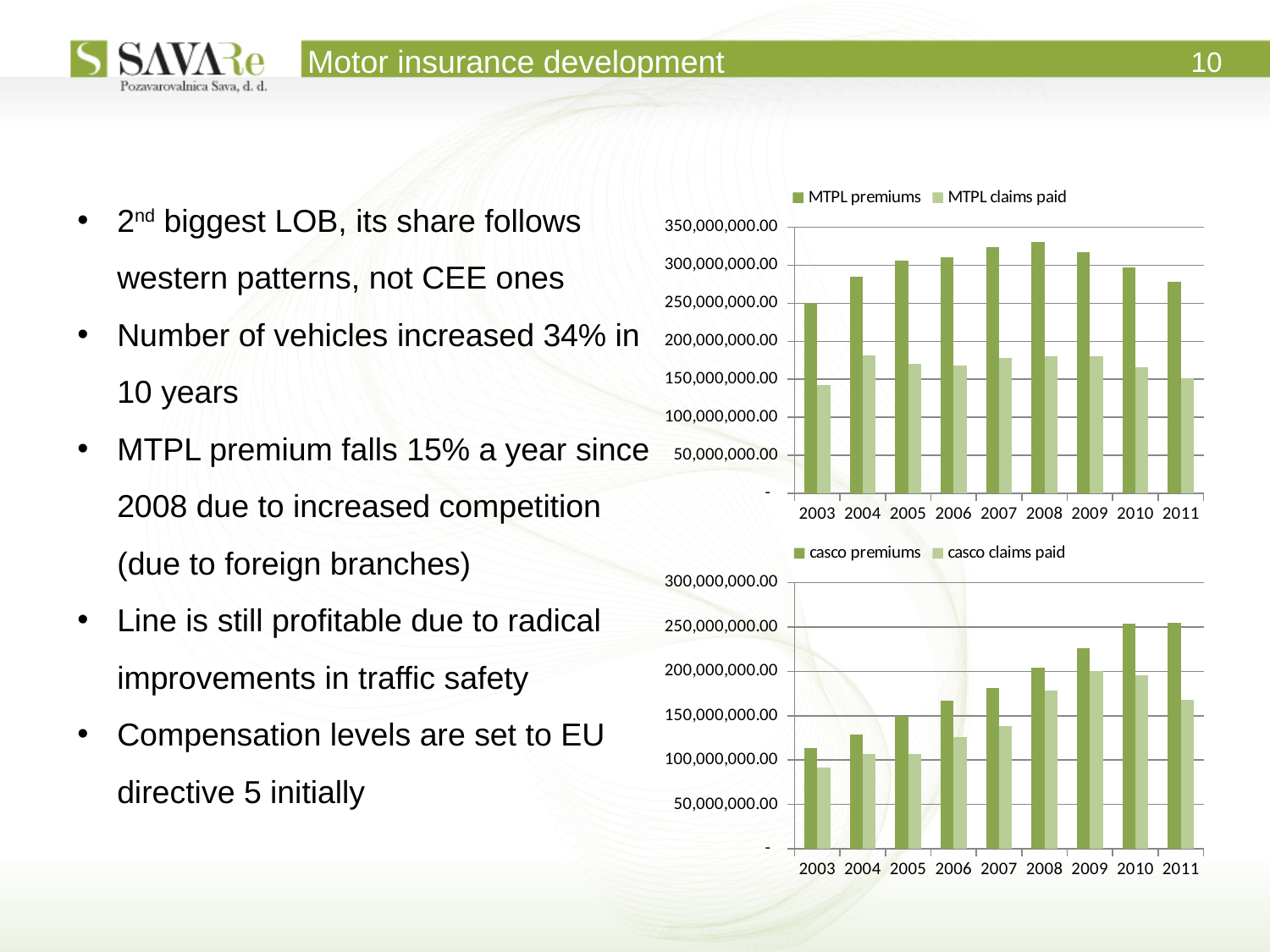
In the top chart (MTPL), which year has the lowest MTPL premiums? 2003 What are the two legend entries of the bottom chart? casco premiums, casco claims paid In the top chart (MTPL), is the value for MTPL claims paid in 2003 greater or less than 150,000,000.00? less How many series does the legend of the bottom chart (casco) list? 2 How many years are shown on the x axis of the top chart (MTPL)? 9 In the top chart (MTPL), which year has the highest MTPL premiums? 2008 In the top chart (MTPL), which is larger in 2011: MTPL premiums or MTPL claims paid? MTPL premiums In the top chart (MTPL), is the value for MTPL premiums in 2003 greater or less than 300,000,000.00? less In the bottom chart (casco), which year has the lowest casco premiums? 2003 In the bottom chart (casco), do casco premiums generally rise or fall from 2003 to 2011? rise What kind of chart is the top chart showing MTPL premiums and MTPL claims paid? bar chart